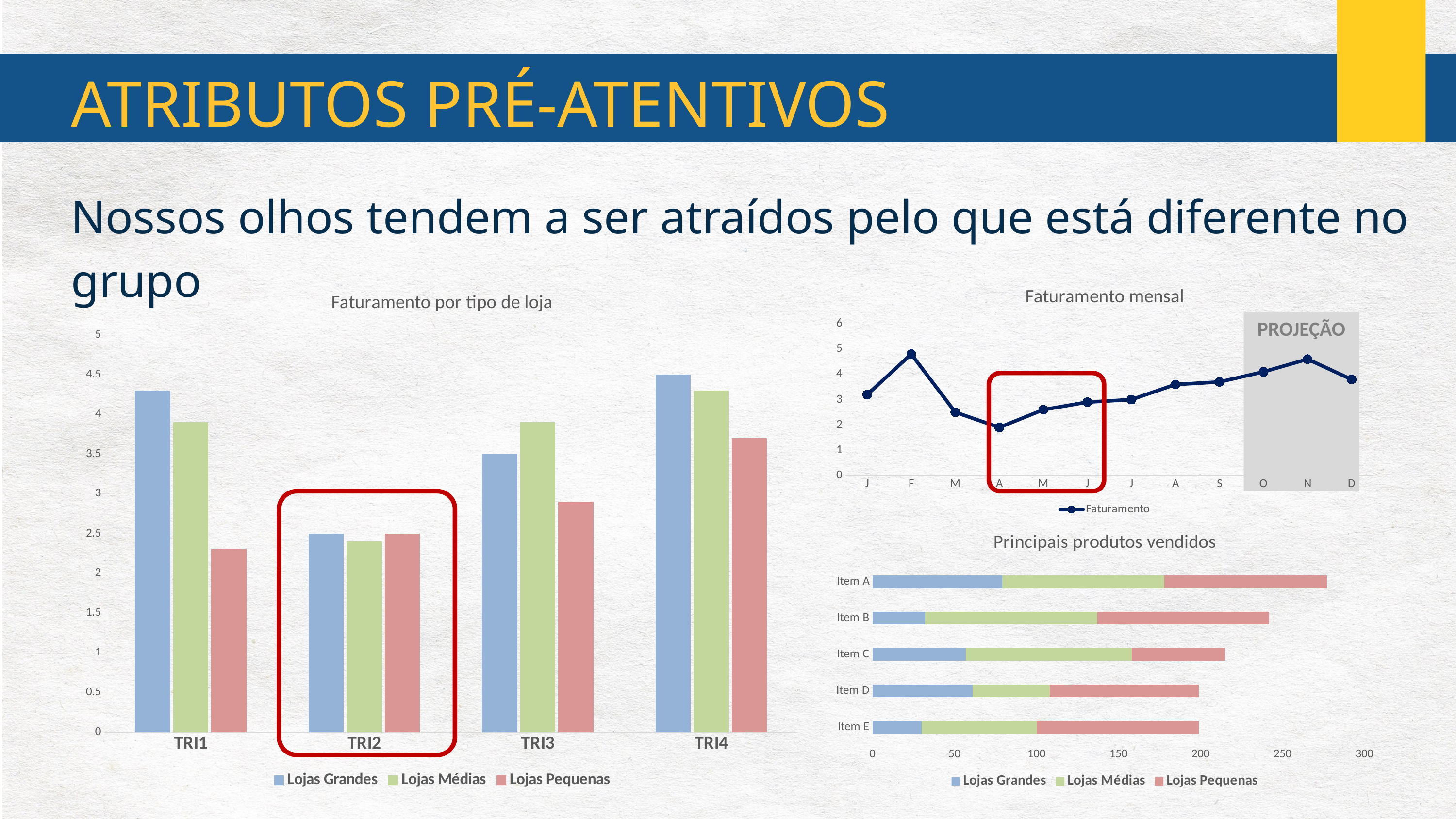
In "Faturamento por tipo de loja", is the value for Lojas Grandes in TRI1 greater or less than 4? greater How many categories are shown on the x axis of "Faturamento por tipo de loja"? 4 In "Faturamento mensal", which month has the lowest value? A In "Faturamento mensal", how many data points are plotted? 12 In "Faturamento por tipo de loja", which is larger in TRI3: Lojas Grandes or Lojas Médias? Lojas Médias How many series does the legend of "Faturamento por tipo de loja" list? 3 What kind of chart is "Faturamento mensal"? line chart In "Faturamento mensal", which month has the highest value? F What kind of chart is "Faturamento por tipo de loja"? bar chart In "Faturamento mensal", what label appears in the grey shaded area on the right? PROJEÇÃO In "Principais produtos vendidos", which item has the longest total bar? Item A In "Faturamento por tipo de loja", is the value for Lojas Pequenas in TRI2 greater or less than 3? less